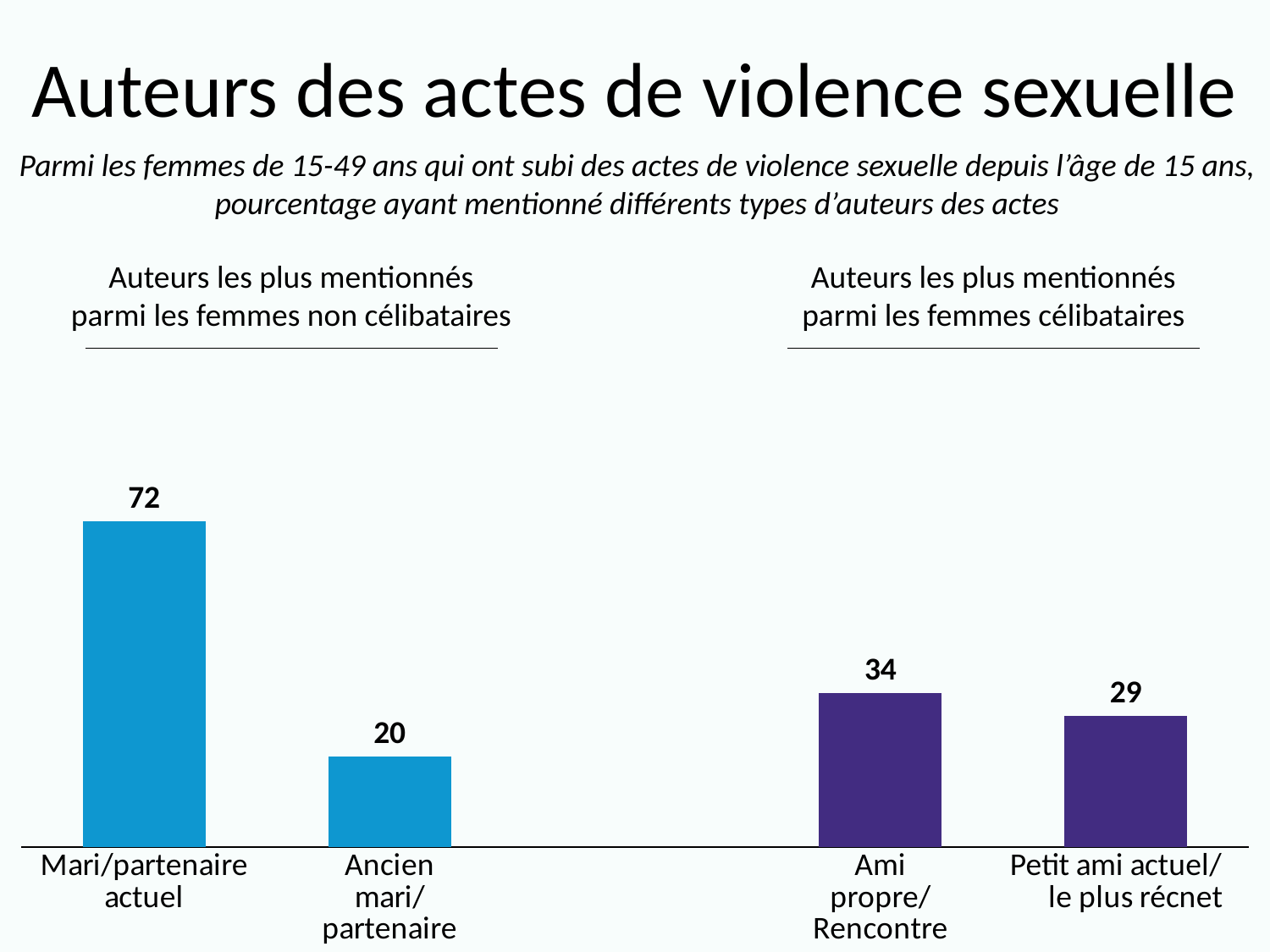
What value is shown for "Mari/partenaire actuel"? 72 What value is shown for "Ancien mari/partenaire"? 20 Which category has the highest value on the chart? Mari/partenaire actuel What kind of chart is shown on the slide? Bar chart What value is shown for "Ami propre/Rencontre"? 34 Which group of bars is shown under the heading "Auteurs les plus mentionnés parmi les femmes célibataires"? Ami propre/Rencontre and Petit ami actuel/le plus récnet How many bars are plotted on the chart? 4 What value is shown for "Petit ami actuel/le plus récnet"? 29 Which category has the lowest value on the chart? Ancien mari/partenaire Which is larger, the value for "Ami propre/Rencontre" or the value for "Petit ami actuel/le plus récnet"? Ami propre/Rencontre What is the difference between the values for "Ami propre/Rencontre" and "Petit ami actuel/le plus récnet"? 5 What is the difference between the values for "Mari/partenaire actuel" and "Ancien mari/partenaire"? 52